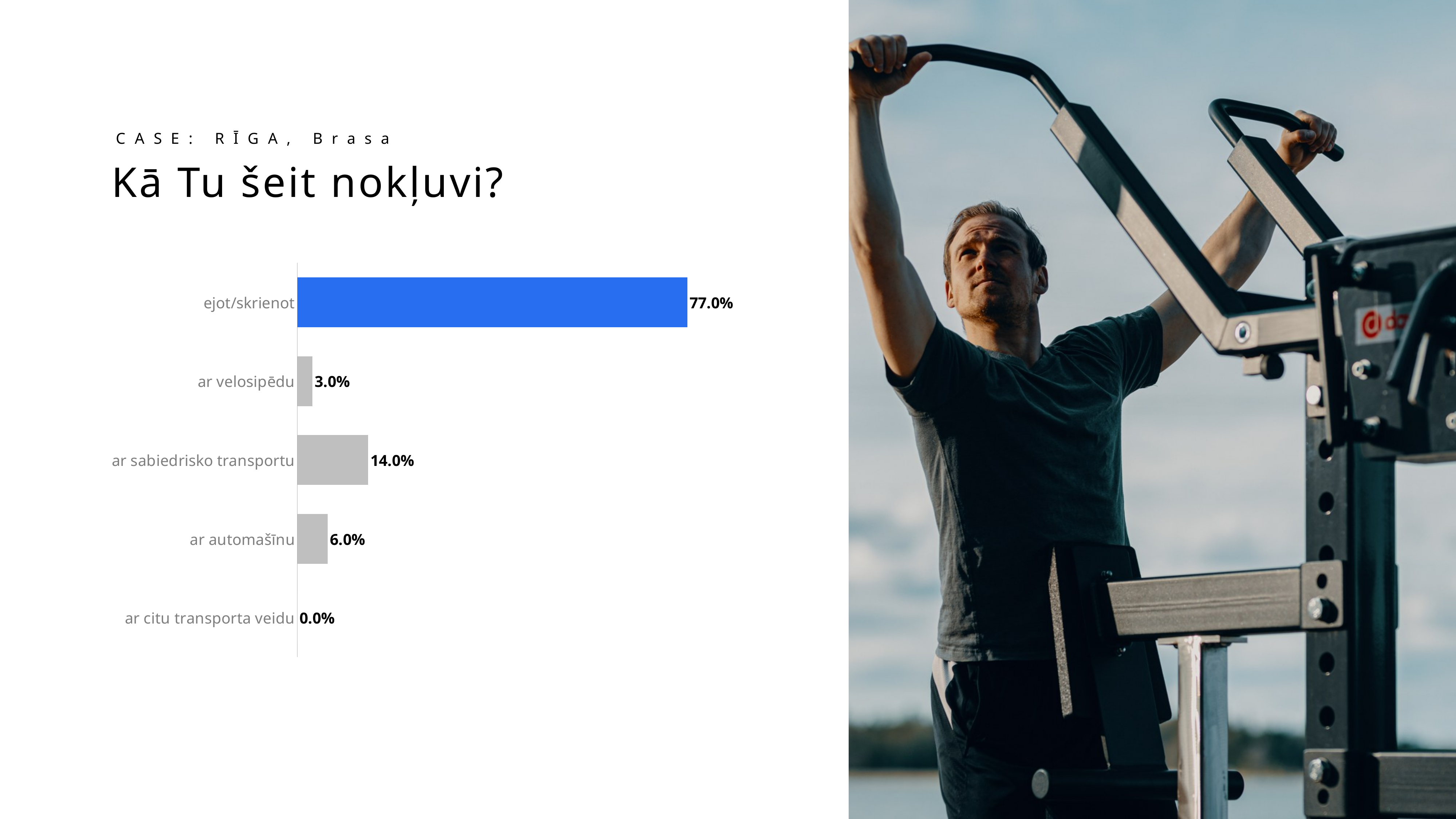
What is the value for ejot/skrienot? 77.0% Which category has the highest value? ejot/skrienot Which category has the lowest value? ar citu transporta veidu What is the value for ar citu transporta veidu? 0.0% What is the value for ar sabiedrisko transportu? 14.0% How many categories are shown in the chart? 5 Which is larger, the value for ar automašīnu or the value for ar velosipēdu? ar automašīnu What is the difference between the values for ejot/skrienot and ar sabiedrisko transportu? 63.0% Which bar is coloured blue rather than grey? ejot/skrienot What kind of chart is shown on the slide? bar chart What is the value for ar automašīnu? 6.0% What is the value for ar velosipēdu? 3.0%